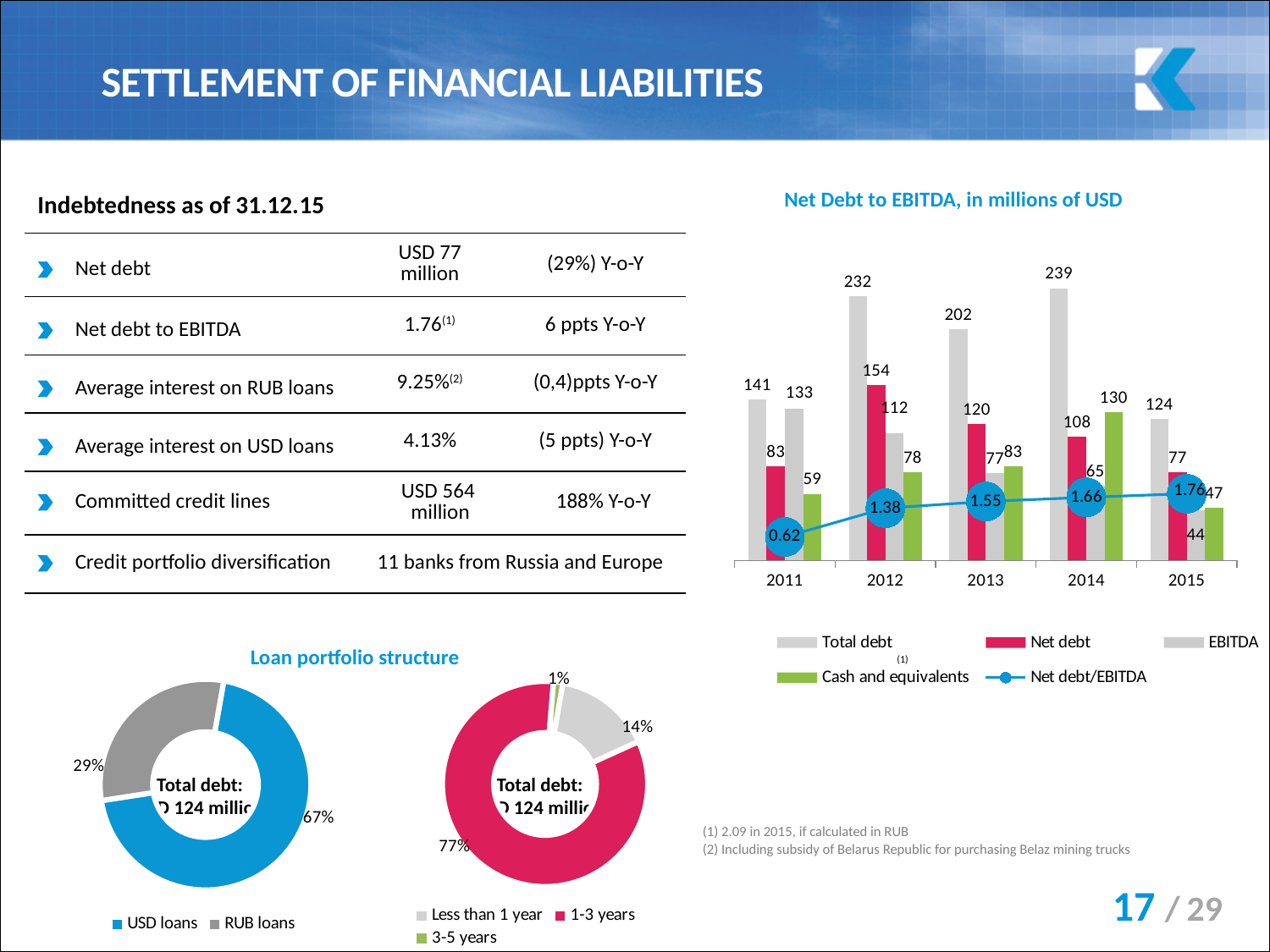
In the 'Net Debt to EBITDA, in millions of USD' chart, which year has the lowest Net debt? 2015 In the 'Net Debt to EBITDA, in millions of USD' chart, does the Net debt/EBITDA line rise or fall from 2011 to 2015? Rise In the 'Net Debt to EBITDA, in millions of USD' chart, what is the difference between Total debt in 2012 and in 2011? 91 In the 'Net Debt to EBITDA, in millions of USD' chart, which is larger in 2014: Net debt or Cash and equivalents? Cash and equivalents In the 'Net Debt to EBITDA, in millions of USD' chart, what is the Net debt/EBITDA value for 2015? 1.76 In the left 'Loan portfolio structure' donut chart, what share is USD loans? 67% In the 'Net Debt to EBITDA, in millions of USD' chart, which year has the highest Total debt? 2014 In the 'Net Debt to EBITDA, in millions of USD' chart, what is the Total debt value for 2014? 239 In the 'Net Debt to EBITDA, in millions of USD' chart, how many series does the legend list? 5 In the right 'Loan portfolio structure' donut chart, what share is 1-3 years? 77% In the 'Net Debt to EBITDA, in millions of USD' chart, what kind of chart is it? Bar chart with a line In the 'Net Debt to EBITDA, in millions of USD' chart, how many years are shown on the x axis? 5